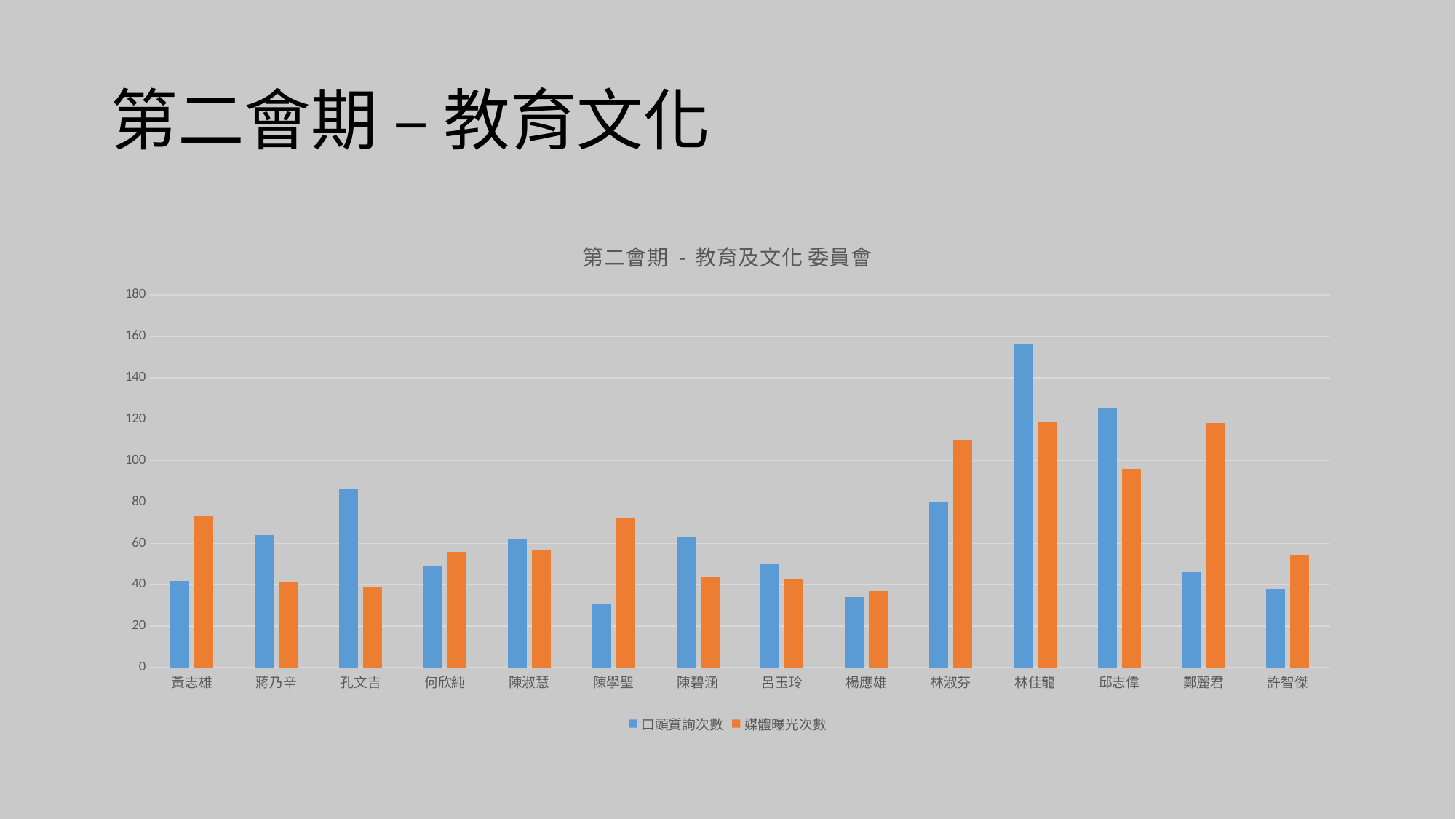
Is the 口頭質詢次數 value for 孔文吉 greater or less than 80? greater Is the 媒體曝光次數 value for 鄭麗君 greater or less than 100? greater What kind of chart is shown on the slide? bar chart What is the title of the chart? 第二會期 - 教育及文化 委員會 Which legislator has the highest 口頭質詢次數? 林佳龍 For 孔文吉, which is larger: 口頭質詢次數 or 媒體曝光次數? 口頭質詢次數 For 鄭麗君, which is larger: 口頭質詢次數 or 媒體曝光次數? 媒體曝光次數 Is the 口頭質詢次數 value for 林佳龍 greater or less than 140? greater How many legislators (categories) are shown on the x axis? 14 How many series does the legend list? 2